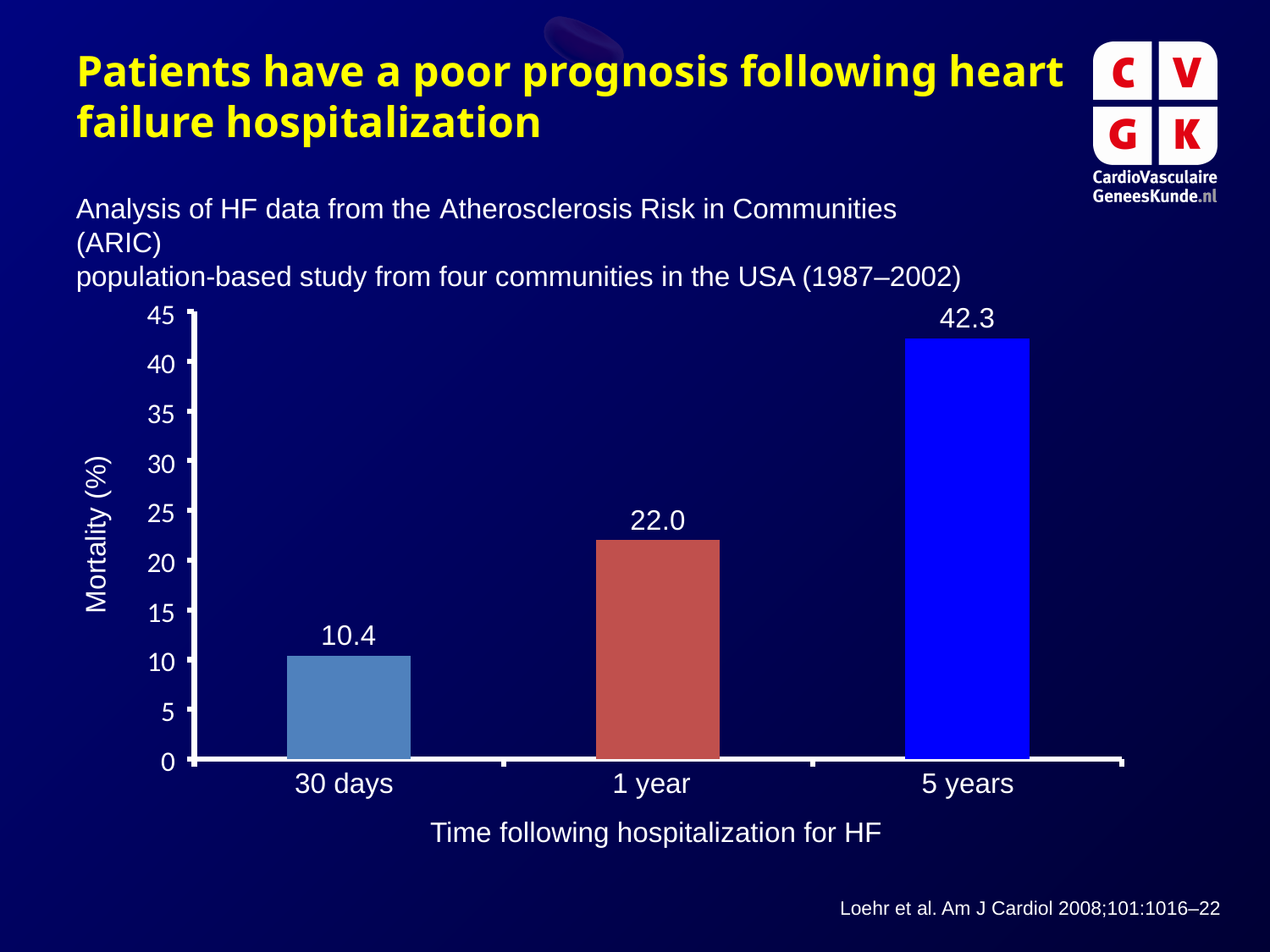
Which has a higher mortality, 30 days or 1 year? 1 year How many time points are shown on the x axis? 3 Is the mortality at 5 years greater or less than 40? greater Does mortality rise or fall as time following hospitalization increases? Rises What is the difference in mortality (%) between 5 years and 1 year? 20.3 Which time point has the highest mortality? 5 years What is the difference in mortality (%) between 1 year and 30 days? 11.6 What is the mortality (%) at 30 days following hospitalization for HF? 10.4 What kind of chart is shown on the slide? Bar chart What is the mortality (%) at 5 years following hospitalization for HF? 42.3 Which time point has the lowest mortality? 30 days What is the mortality (%) at 1 year following hospitalization for HF? 22.0